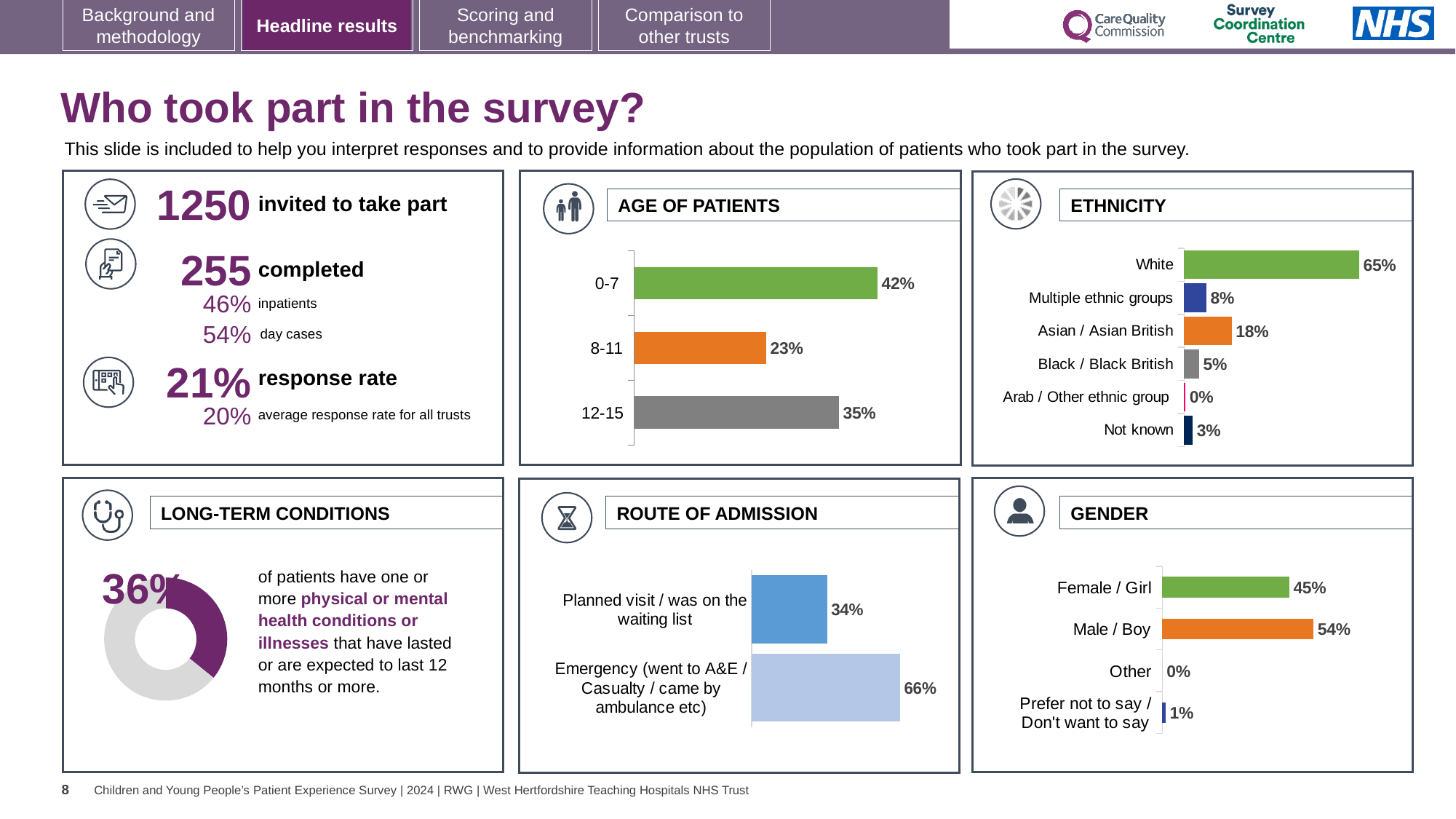
In the ROUTE OF ADMISSION chart, what is the difference between the Emergency and Planned visit percentages? 32% What kind of chart is the LONG-TERM CONDITIONS chart? Doughnut chart How many categories are shown in the ETHNICITY chart? 6 In the AGE OF PATIENTS chart, which age group has the lowest percentage? 8-11 In the GENDER chart, which category has the lowest percentage? Other In the ROUTE OF ADMISSION chart, what percentage of patients came via Emergency (went to A&E / Casualty / came by ambulance etc)? 66% In the ETHNICITY chart, which is larger: Multiple ethnic groups or Black / Black British? Multiple ethnic groups In the AGE OF PATIENTS chart, what is the difference between the 0-7 and 12-15 percentages? 7% In the ETHNICITY chart, what percentage of patients were Asian / Asian British? 18% In the GENDER chart, what percentage of patients were Male / Boy? 54% In the AGE OF PATIENTS chart, what percentage of patients were aged 0-7? 42% In the ETHNICITY chart, which category has the highest percentage? White